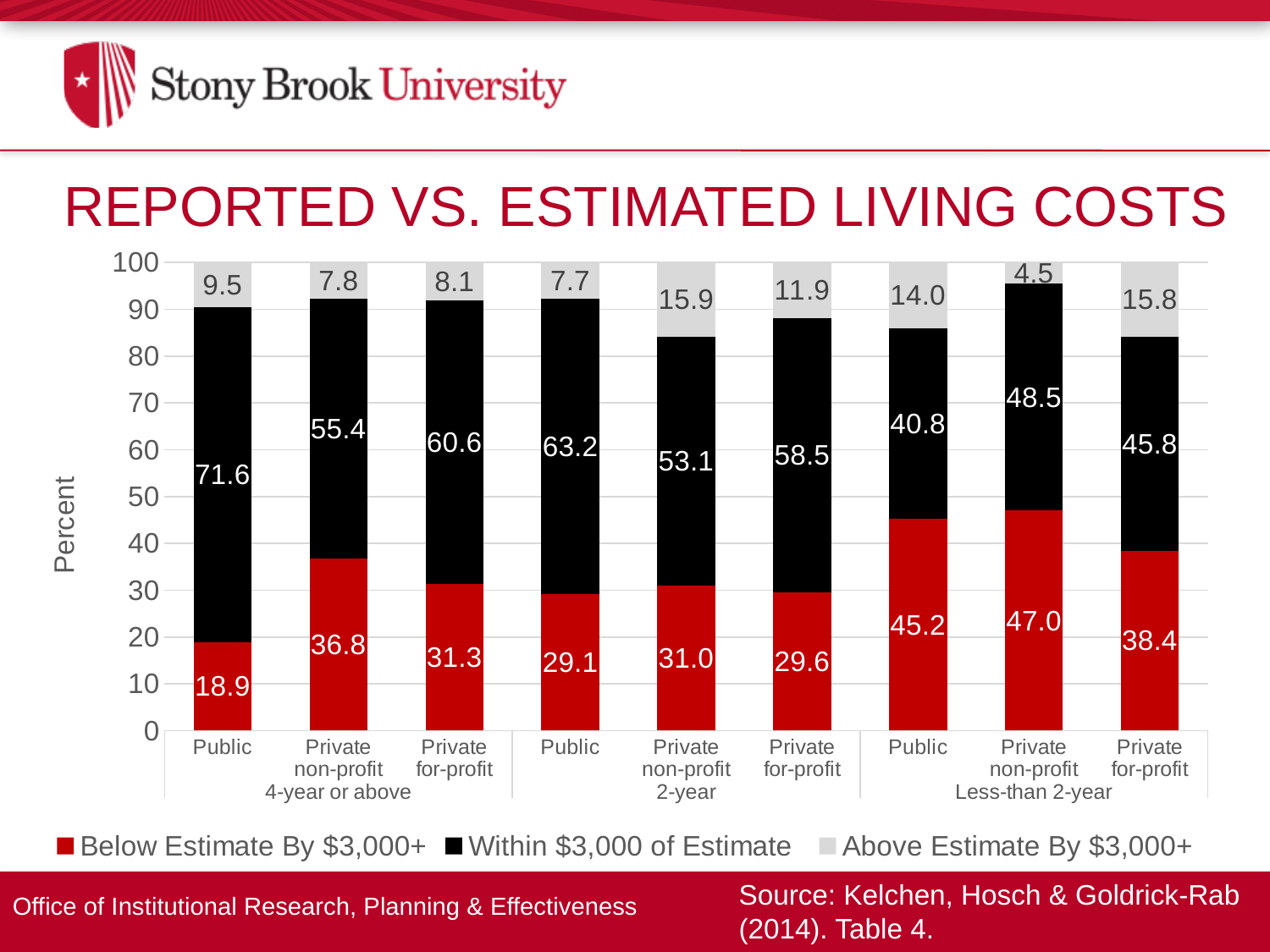
What kind of chart is shown on the slide? Stacked bar chart What is the total of the stacked bar for Private for-profit institutions in the 2-year group? 100 How many bars (categories) are shown in the chart? 9 What is the difference between the "Below Estimate By $3,000+" values for Private non-profit and Public institutions in the 4-year or above group? 17.9 Which category has the lowest "Above Estimate By $3,000+" value? Private non-profit (Less-than 2-year) Which is larger: the "Below Estimate By $3,000+" value for Public in the Less-than 2-year group or for Public in the 2-year group? Public in the Less-than 2-year group What is the value of "Below Estimate By $3,000+" for Public institutions in the 4-year or above group? 18.9 What is the value of "Above Estimate By $3,000+" for Private non-profit institutions in the 2-year group? 15.9 What is the value of "Within $3,000 of Estimate" for Private non-profit institutions in the Less-than 2-year group? 48.5 What is the title of the chart? REPORTED VS. ESTIMATED LIVING COSTS How many series does the legend list? 3 Which category has the highest "Within $3,000 of Estimate" value? Public (4-year or above)